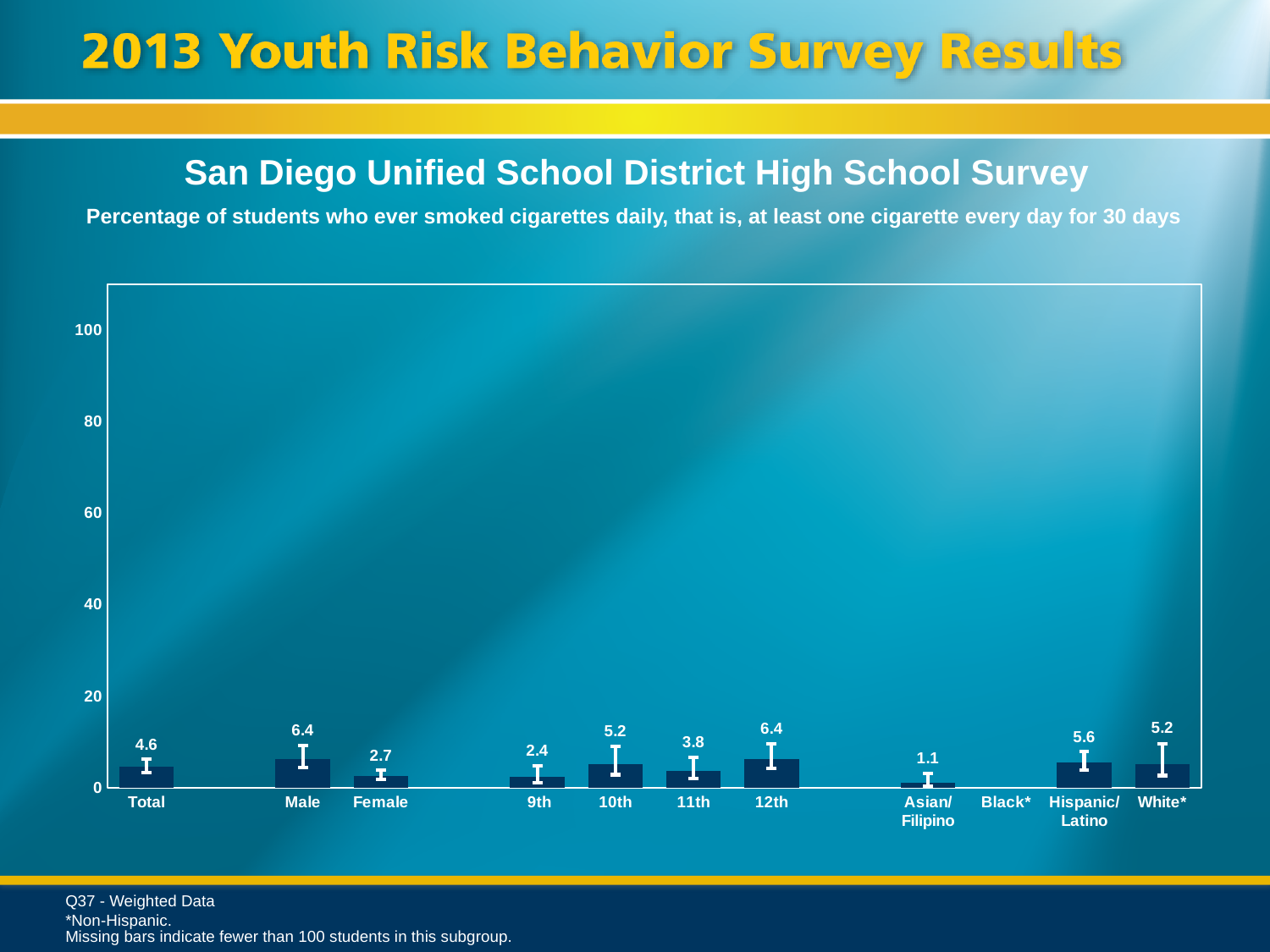
Is the value for 12th greater or less than 20? less What is the value for Female? 2.7 What is the difference between the values for Male and Female? 3.7 Which category has the lowest value? Asian/Filipino How many category labels are shown on the x axis? 11 Which category on the x axis has no bar plotted? Black* Among the grade levels (9th, 10th, 11th, 12th), which has the highest value? 12th What is the value for Asian/Filipino? 1.1 What is the value for Total? 4.6 What is the value for Hispanic/Latino? 5.6 Which is larger, the value for 10th or the value for 11th? 10th What kind of chart is shown? bar chart